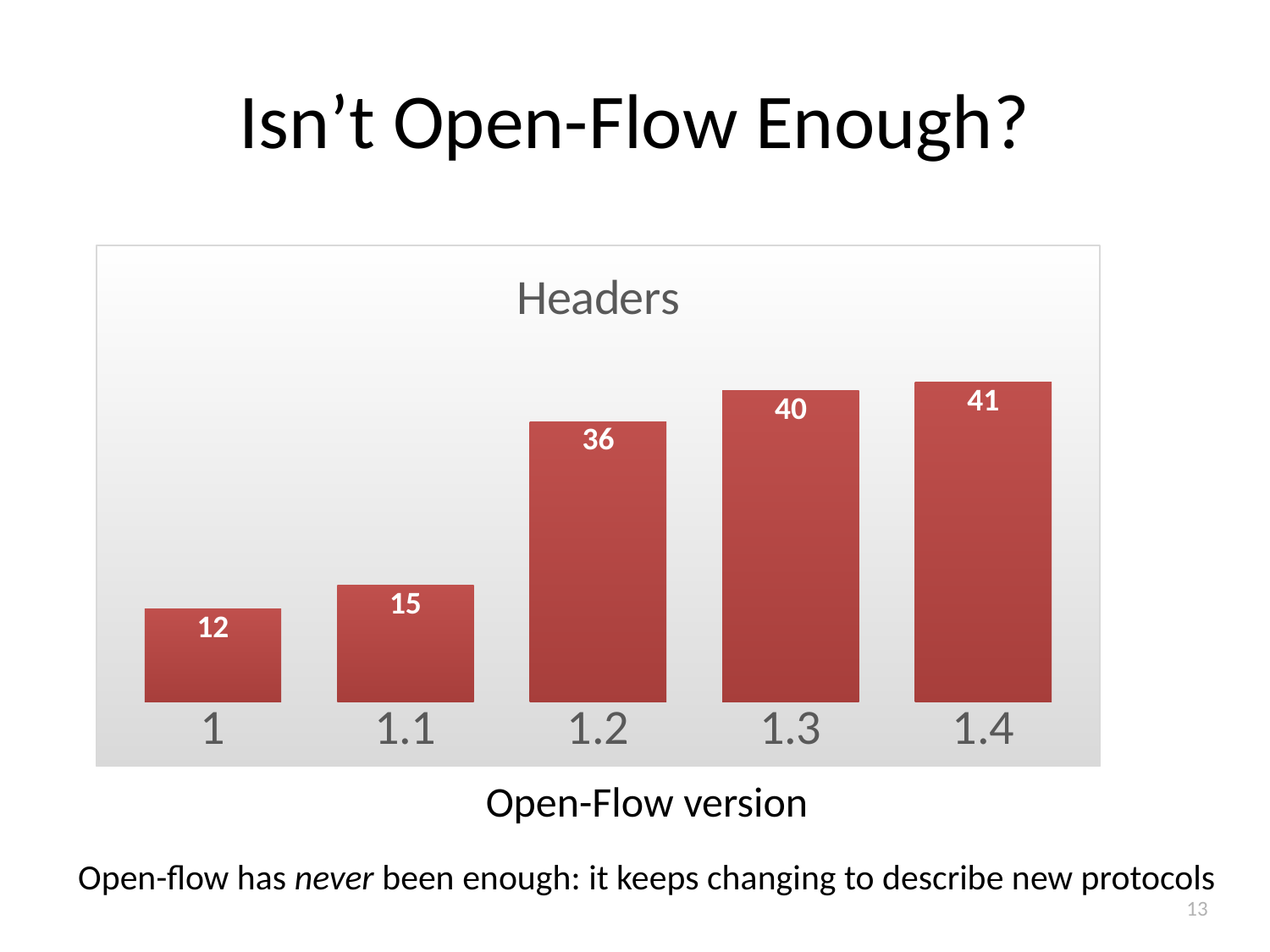
How many Open-Flow versions are shown on the chart? 5 What is the number of headers for Open-Flow version 1.4? 41 What is the difference in headers between Open-Flow version 1.4 and version 1.3? 1 Do the header counts rise or fall as the Open-Flow version increases? Rise Which has more headers, Open-Flow version 1.1 or version 1.3? 1.3 What is the number of headers for Open-Flow version 1.2? 36 What is the title of the chart? Headers What is the number of headers for Open-Flow version 1? 12 Which Open-Flow version has the highest number of headers? 1.4 Which Open-Flow version has the lowest number of headers? 1 What kind of chart is shown on the slide? Bar chart What is the difference in headers between Open-Flow version 1.2 and version 1.1? 21